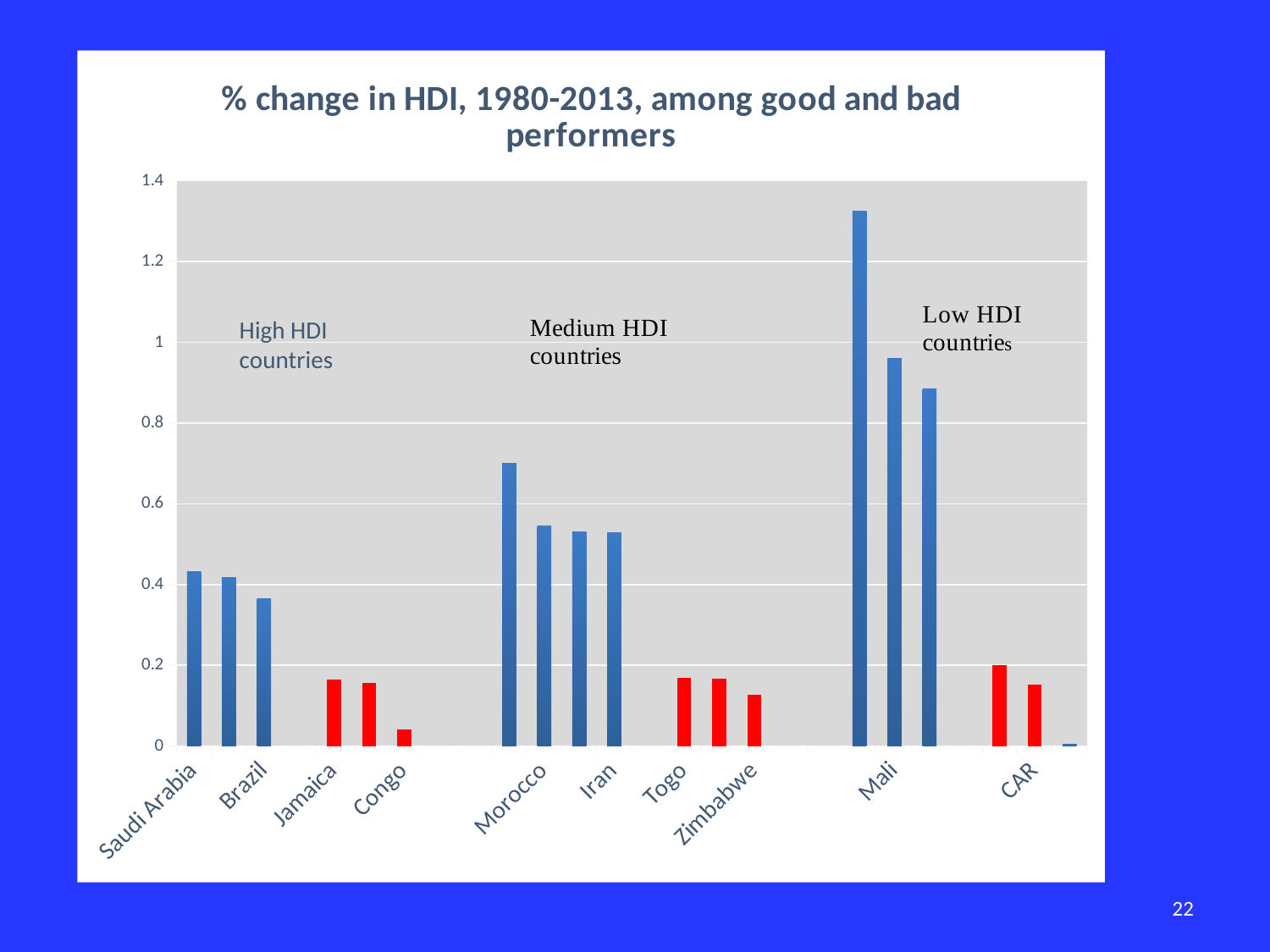
How many country groups are labelled on the chart? 3 Is the value for Saudi Arabia greater or less than 0.6? less Is the value for Morocco greater or less than 0.4? greater Is the value for Congo greater or less than 0.2? less What is the title of the chart? % change in HDI, 1980-2013, among good and bad performers Which has the larger value, Morocco or Togo? Morocco Which has the larger value, Mali or Saudi Arabia? Mali Which has the larger value, Iran or Zimbabwe? Iran What kind of chart is shown on the slide? bar chart